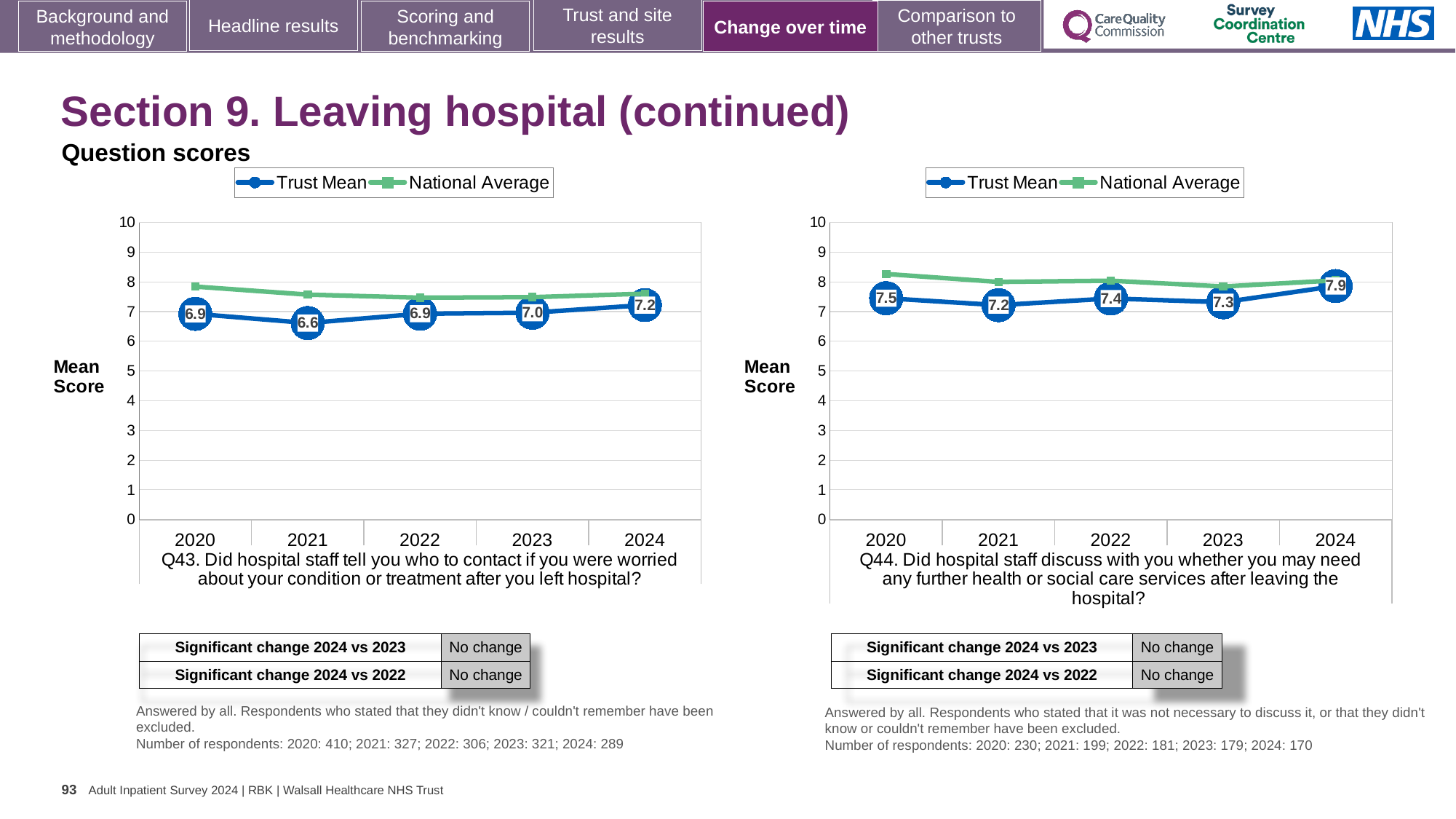
How many series does the legend of the Q44 chart on the right list? 2 In the Q43 chart on the left, what is the Trust Mean score for 2021? 6.6 In the Q44 chart on the right, is the National Average value for 2020 greater or less than 8? greater In the Q44 chart on the right, what is the Trust Mean score for 2020? 7.5 In the Q44 chart on the right, what is the difference between the Trust Mean scores for 2024 and 2023? 0.6 In the Q44 chart on the right, which year has the highest Trust Mean score? 2024 In the Q43 chart on the left, which year has the lowest Trust Mean score? 2021 In the Q43 chart on the left, is the National Average value for 2022 greater or less than 8? less In the Q43 chart on the left, what is the Trust Mean score for 2024? 7.2 How many years are shown on the x axis of the Q43 chart on the left? 5 In the Q43 chart on the left, is the Trust Mean score for 2023 higher or lower than the Trust Mean score for 2021? higher What type of chart is the Q43 chart on the left? Line chart